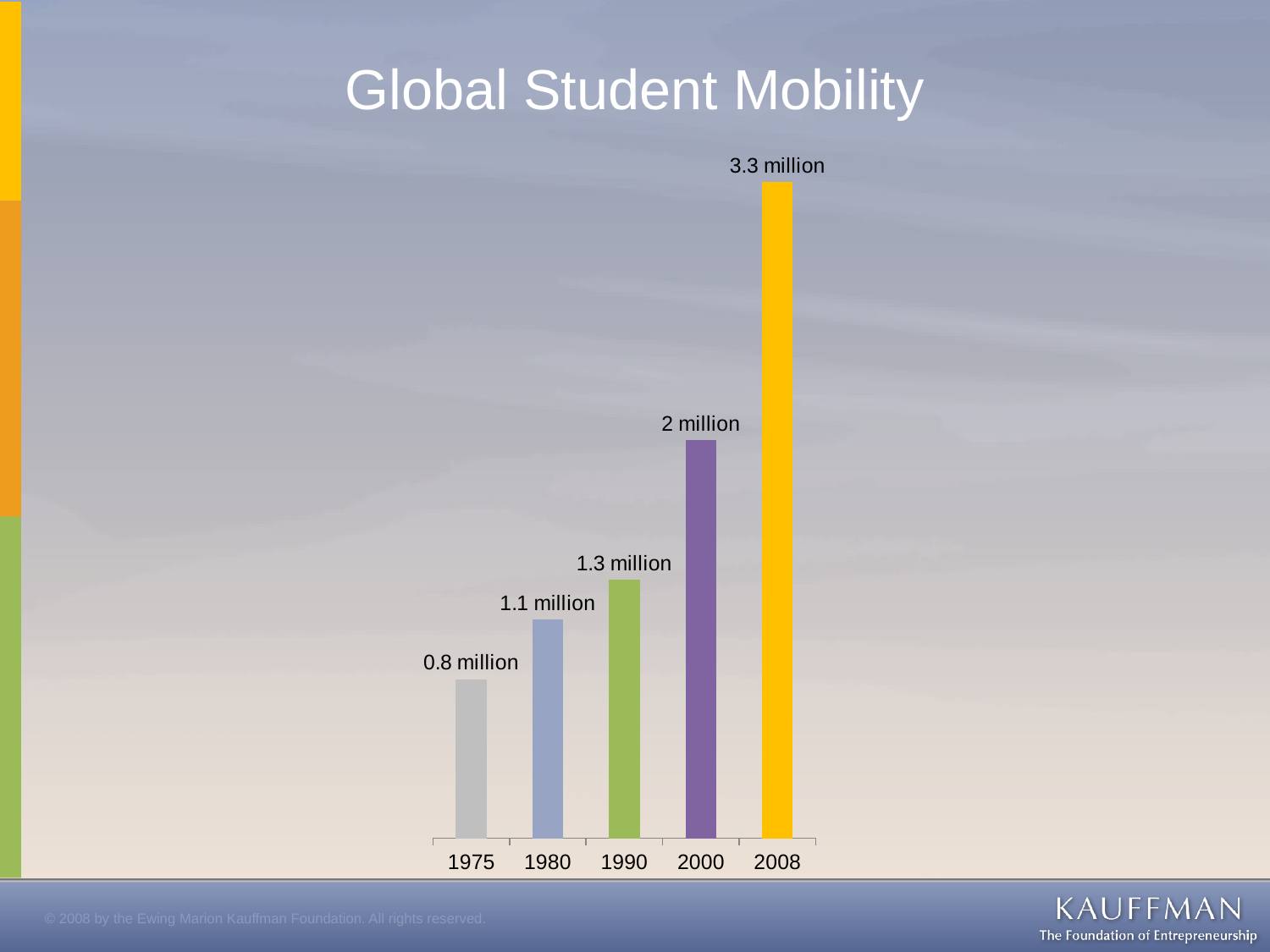
What kind of chart is shown on the slide? Bar chart What is the title of the chart? Global Student Mobility Which year has the lowest value? 1975 What is the difference between the values for 1980 and 1975? 0.3 million What is the value for 1975? 0.8 million Which year has the highest value? 2008 What is the value for 1990? 1.3 million Which is larger, the value for 1990 or the value for 2000? 2000 What is the difference between the values for 2008 and 2000? 1.3 million What is the value for 2008? 3.3 million How many years are shown on the x axis? 5 Do the values rise or fall from 1975 to 2008? Rise